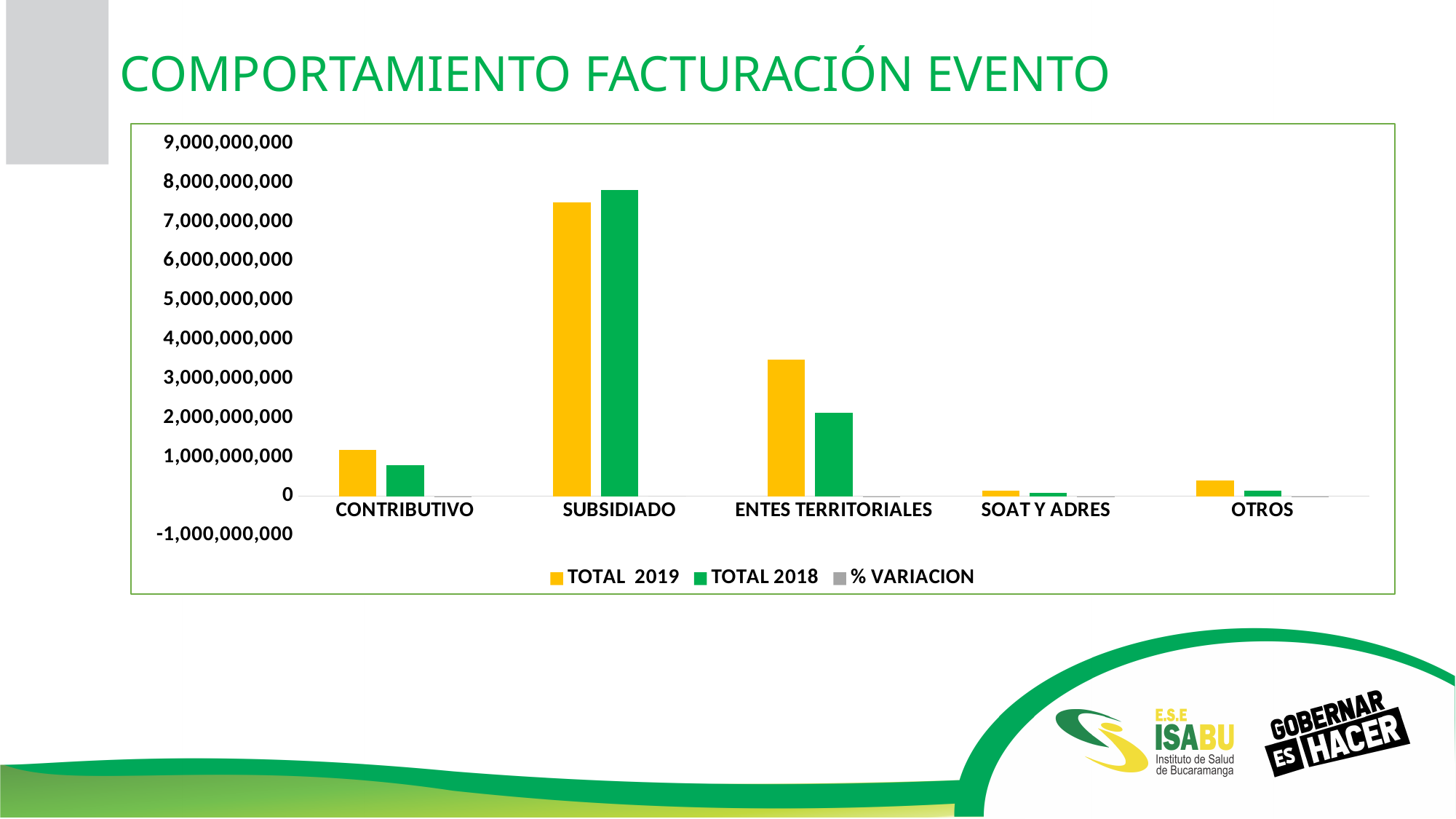
What type of chart is shown on the slide? Bar chart How many series does the chart's legend list? 3 Is the TOTAL 2018 value for CONTRIBUTIVO greater or less than 1,000,000,000? less Which category has the highest TOTAL 2019 value? SUBSIDIADO How many categories are shown on the x axis of the chart? 5 Is the TOTAL 2019 value for ENTES TERRITORIALES greater or less than 3,000,000,000? greater Which category has the highest TOTAL 2018 value? SUBSIDIADO For SUBSIDIADO, which is larger: TOTAL 2019 or TOTAL 2018? TOTAL 2018 Which category has the lowest TOTAL 2019 value? SOAT Y ADRES For ENTES TERRITORIALES, which is larger: TOTAL 2019 or TOTAL 2018? TOTAL 2019 Is the TOTAL 2019 value for SUBSIDIADO greater or less than 7,000,000,000? greater What is the title of the chart on the slide? COMPORTAMIENTO FACTURACIÓN EVENTO